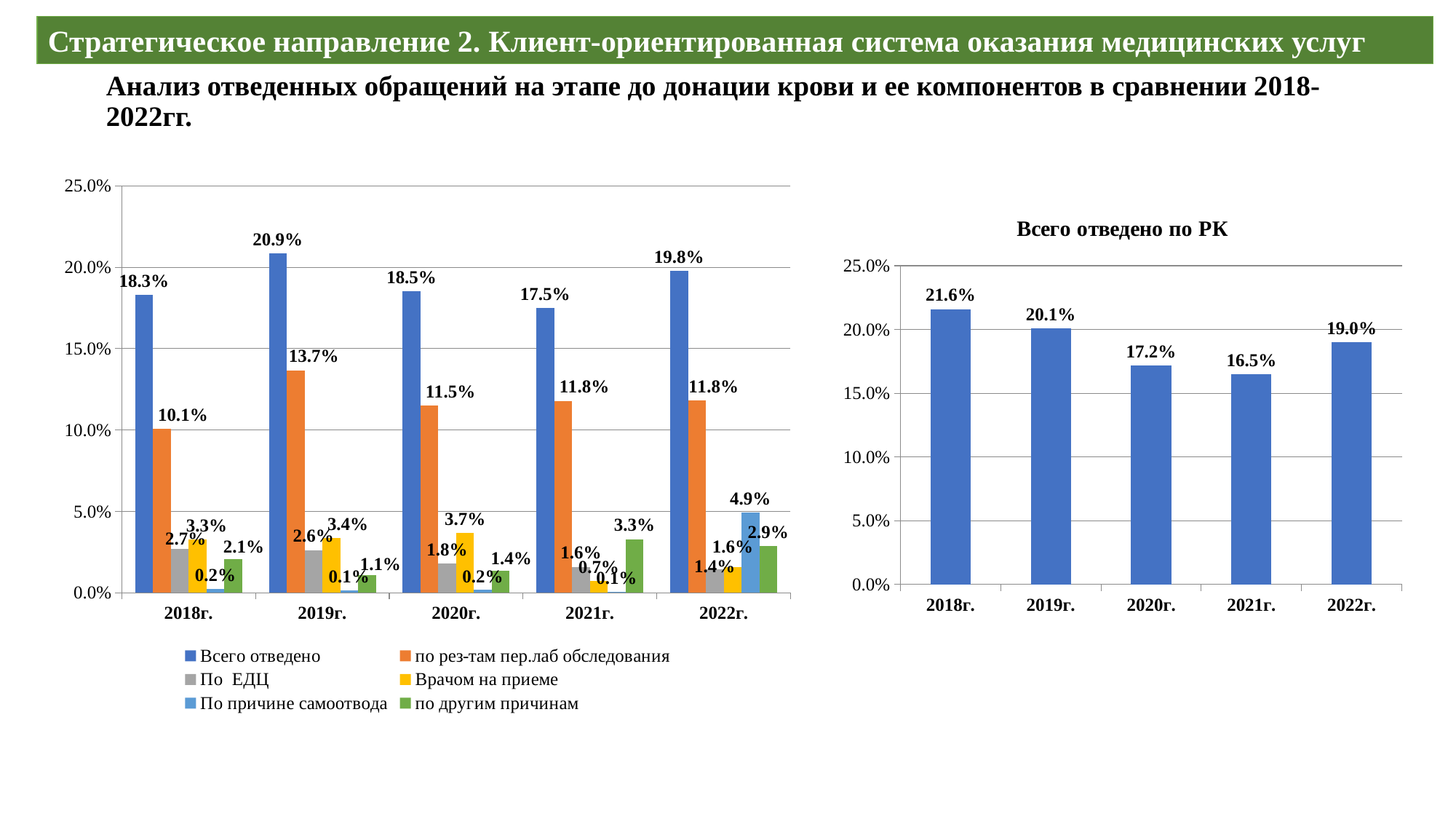
In the chart titled 'Всего отведено по РК', what is the value for 2018г.? 21.6% In the left chart, what is the value of 'Всего отведено' for 2019г.? 20.9% In the chart titled 'Всего отведено по РК', how many years are shown on the x axis? 5 In the left chart, which year has the highest value for 'Всего отведено'? 2019г. In the chart titled 'Всего отведено по РК', what is the difference between the 2018г. and 2022г. values? 2.6% What type of chart is the chart titled 'Всего отведено по РК'? bar chart In the left chart, which is larger for 2021г.: 'Врачом на приеме' or 'по другим причинам'? по другим причинам In the left chart, what is the value of 'По причине самоотвода' for 2022г.? 4.9% In the chart titled 'Всего отведено по РК', which year has the lowest value? 2021г. In the chart titled 'Всего отведено по РК', do the values rise or fall from 2018г. to 2021г.? fall In the left chart, how many series does the legend list? 6 In the left chart, what is the value of 'по рез-там пер.лаб обследования' for 2020г.? 11.5%